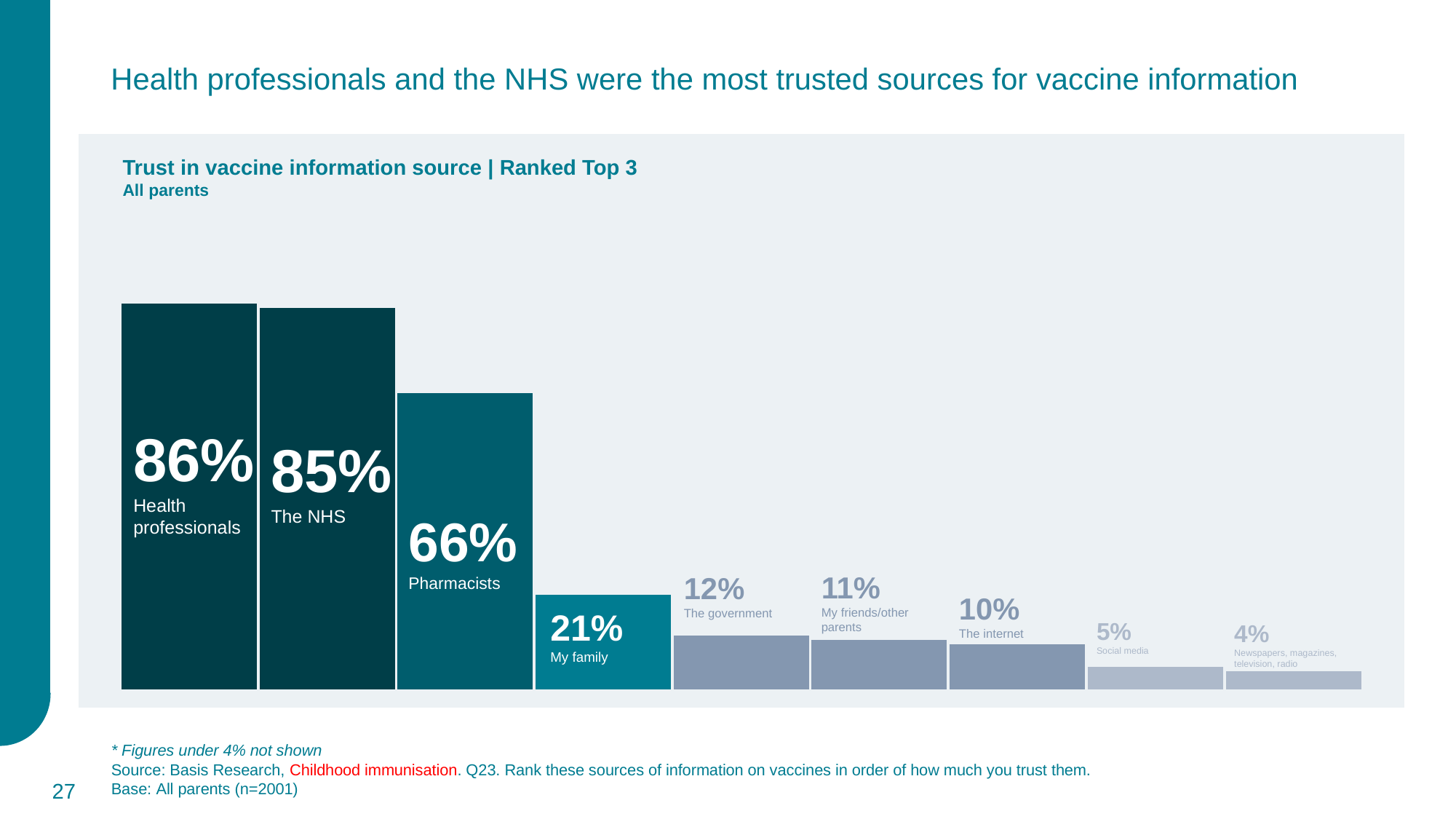
Which source has the highest value in the chart? Health professionals What kind of chart is shown on the slide? Bar chart What is the value shown for Pharmacists? 66% Which source has the lowest value shown in the chart? Newspapers, magazines, television, radio What is the value shown for The government? 12% Which has a higher value, The internet or My friends/other parents? My friends/other parents What is the value shown for Social media? 5% What percentage of parents ranked health professionals in their top 3 trusted sources for vaccine information? 86% Do the values rise or fall from left to right across the chart? Fall What is the difference between the values for The NHS and My family? 64 percentage points How many sources are shown in the chart? 9 What is the title of the chart? Trust in vaccine information source | Ranked Top 3